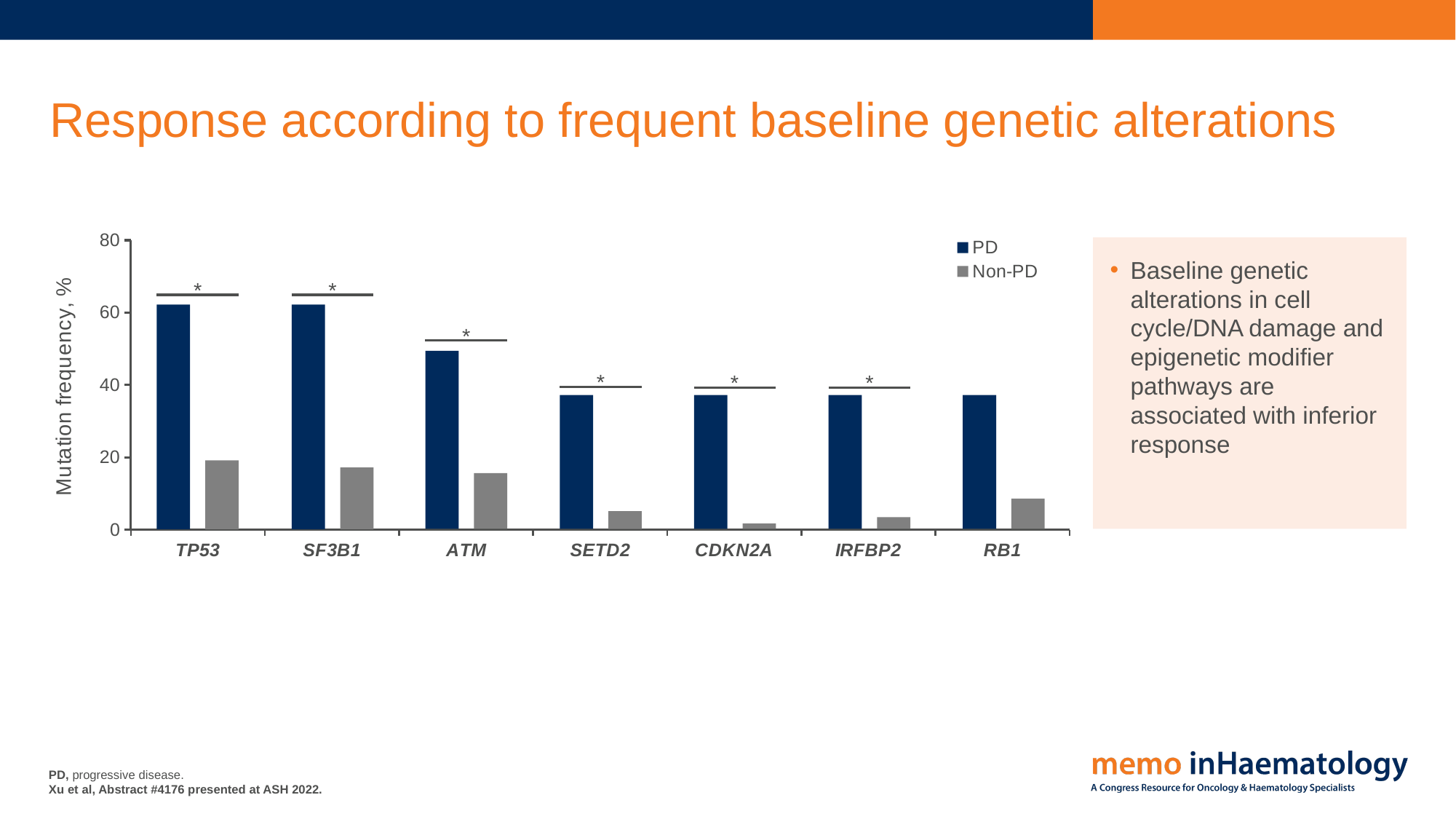
Is the PD mutation frequency for SETD2 greater or less than 40? less Is the PD mutation frequency for TP53 greater or less than 60? greater What are the two series named in the chart legend? PD and Non-PD What is the label of the y axis of the chart? Mutation frequency, % Which gene has the lowest Non-PD mutation frequency? CDKN2A Is the PD mutation frequency for ATM greater or less than 60? less What kind of chart is shown on the slide? Bar chart How many genes are shown on the x axis of the chart? 7 How many series does the chart legend list? 2 Which is larger, the PD mutation frequency for ATM or the PD mutation frequency for SETD2? ATM For ATM, which series has the higher mutation frequency, PD or Non-PD? PD